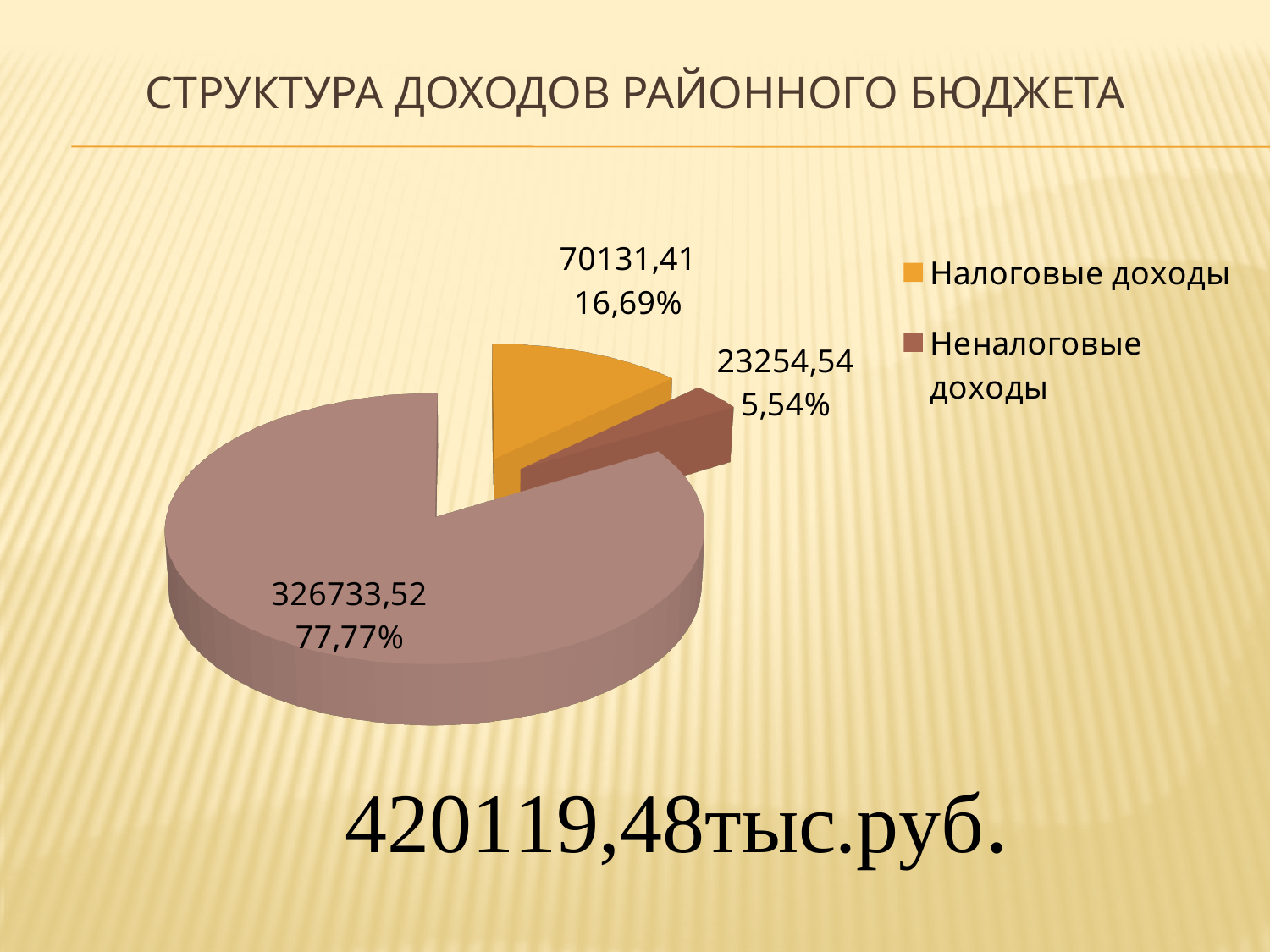
What is the value shown for Неналоговые доходы? 23254,54 What share of the pie does Налоговые доходы represent? 16,69% What share of the pie does Неналоговые доходы represent? 5,54% What is the value printed on the largest slice of the pie? 326733,52 What is the difference between the values for Налоговые доходы and Неналоговые доходы? 46876,87 What is the value shown for Налоговые доходы? 70131,41 How many entries does the legend list? 2 Which is larger, Налоговые доходы or Неналоговые доходы? Налоговые доходы What share of the pie does the largest slice represent? 77,77% What kind of chart is shown on the slide? pie chart Which of the two legend categories has the smallest slice? Неналоговые доходы How many slices does the pie chart have? 3